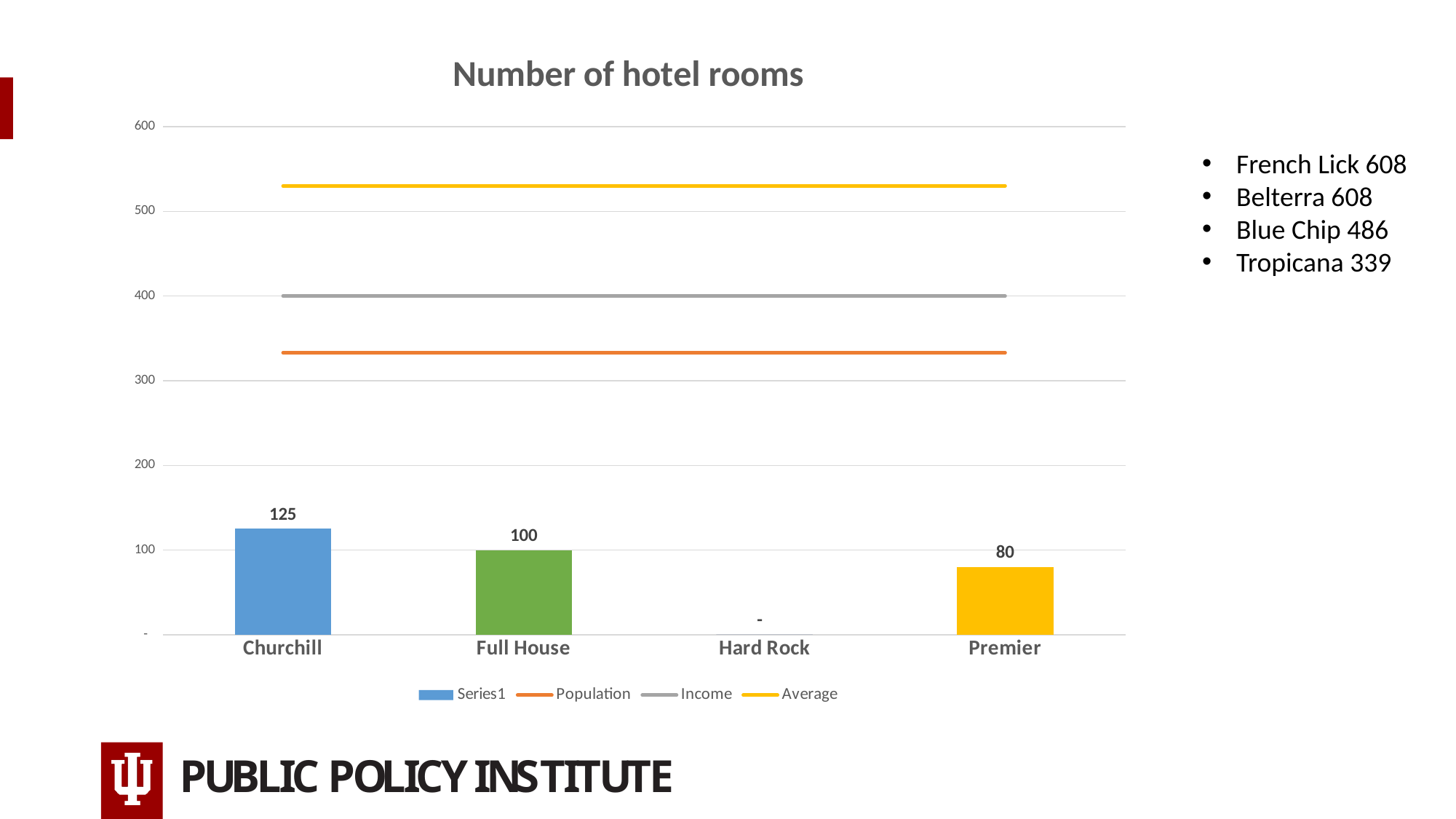
How many series does the chart legend list? 4 Which category has the highest bar in the Number of hotel rooms chart? Churchill What is the value for Churchill in the Number of hotel rooms chart? 125 Which is larger, the value for Full House or the value for Premier? Full House What is the difference between the values for Churchill and Premier? 45 What is the title of the chart on the slide? Number of hotel rooms What kind of chart is used to show the number of hotel rooms by category? bar chart Is the Population line in the chart greater or less than 400? less Is the Average line in the chart greater or less than 500? greater What is the value for Full House in the Number of hotel rooms chart? 100 How many categories are shown on the x axis of the chart? 4 What is the value for Premier in the Number of hotel rooms chart? 80